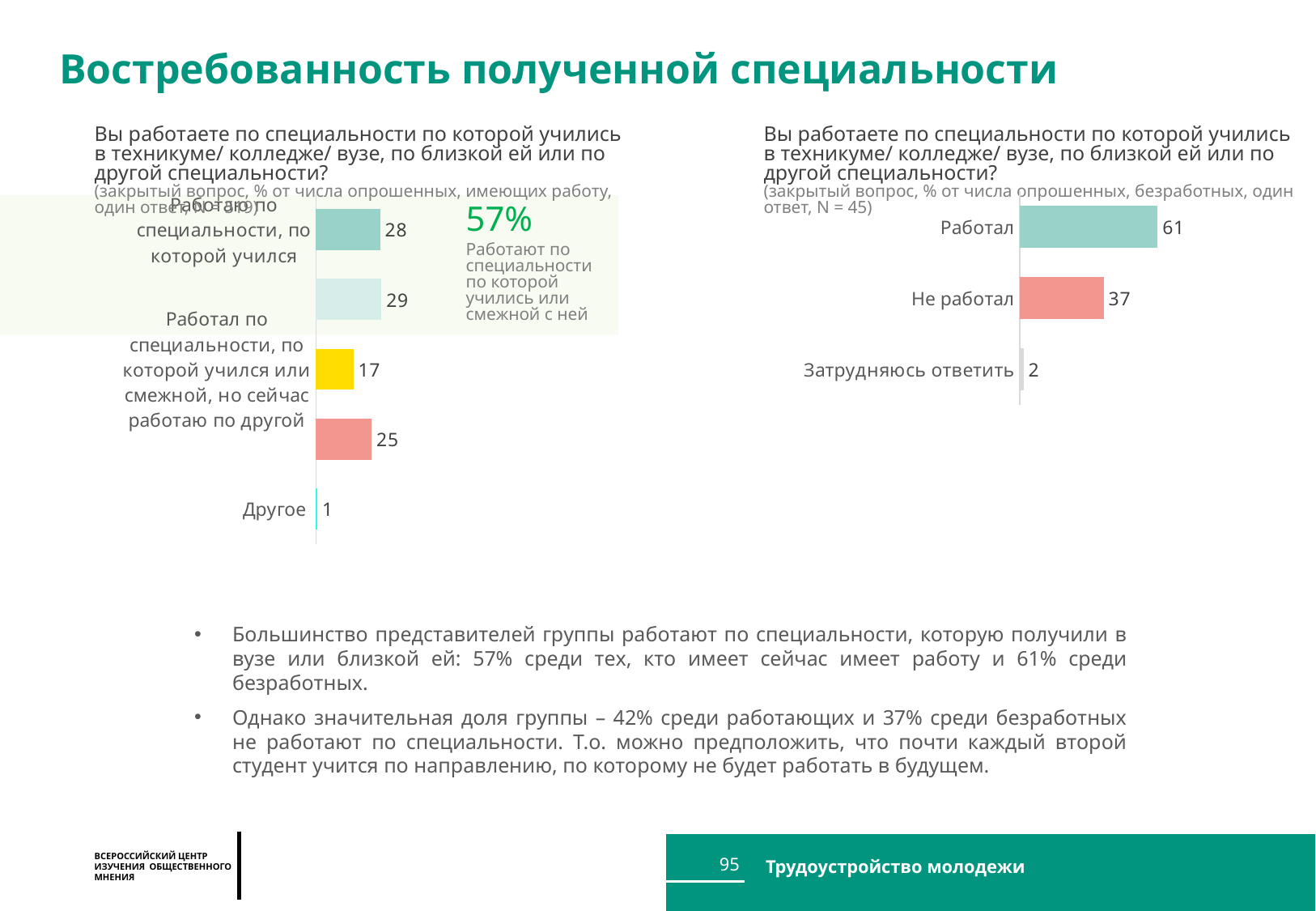
On the right chart (unemployed respondents), what is the difference between 'Работал' and 'Не работал'? 24 On the right chart (unemployed respondents), what is the value for 'Затрудняюсь ответить'? 2 On the right chart (unemployed respondents), what is the value for 'Работал'? 61 On the right chart (unemployed respondents), how many categories are shown? 3 On the left chart (employed respondents), which category has the lowest value? Другое On the left chart (employed respondents), what is the value for 'Работаю по специальности, по которой учился'? 28 On the right chart (unemployed respondents), which category has the highest value? Работал On the right chart (unemployed respondents), which category has the lowest value? Затрудняюсь ответить What type of chart is used on the right side of the slide? Bar chart On the left chart (employed respondents), how many bars are plotted? 5 On the left chart (employed respondents), what is the value for 'Другое'? 1 On the right chart (unemployed respondents), what is the value for 'Не работал'? 37